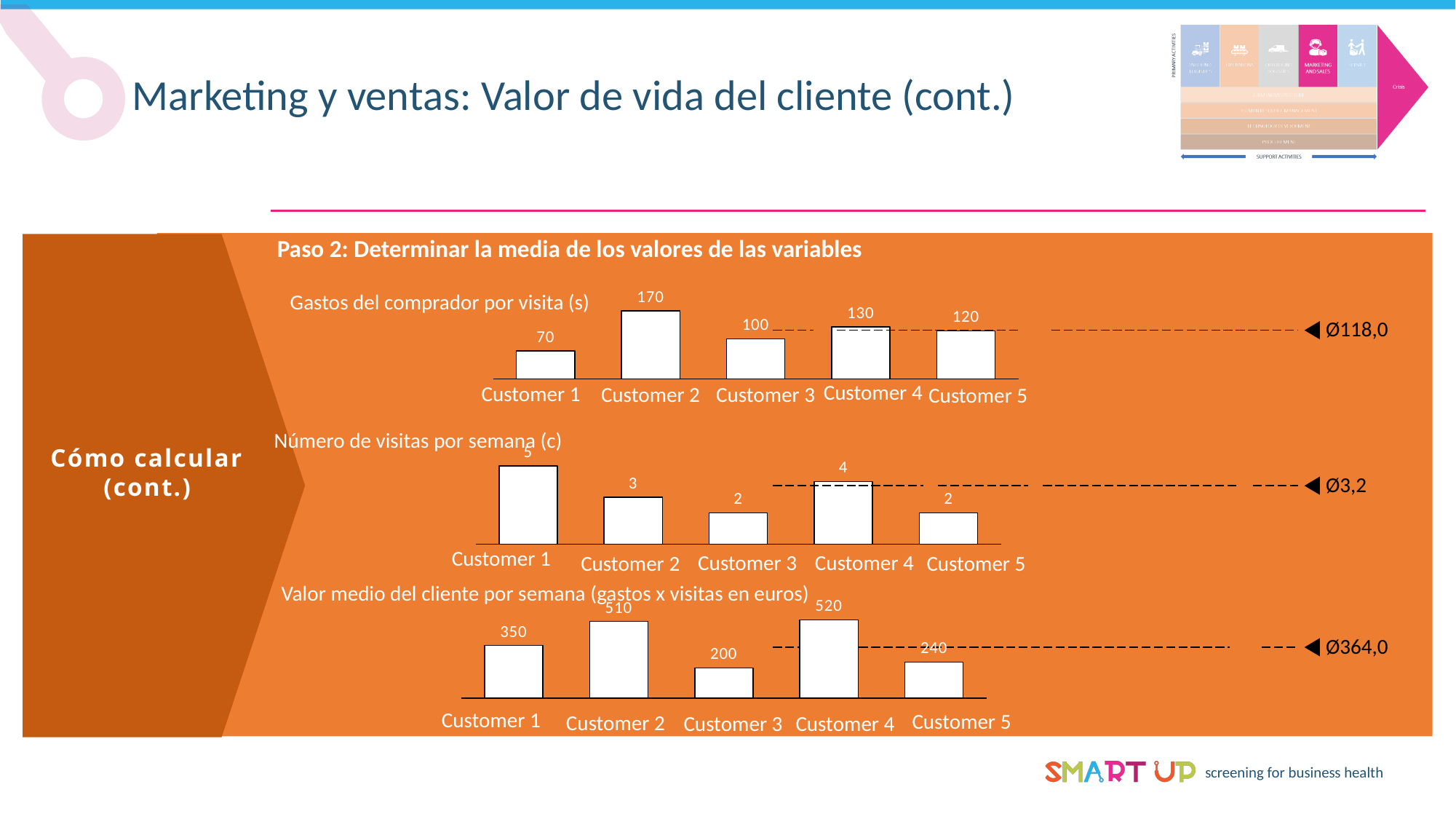
In the 'Gastos del comprador por visita (s)' chart, what is the value for Customer 2? 170 In the 'Número de visitas por semana (c)' chart, what is the value for Customer 4? 4 What kind of chart is the 'Gastos del comprador por visita (s)' chart? Bar chart In the 'Valor medio del cliente por semana' chart, which is larger, Customer 1 or Customer 5? Customer 1 What average value is shown to the right of the 'Valor medio del cliente por semana' chart? Ø364,0 What average value is shown to the right of the 'Número de visitas por semana (c)' chart? Ø3,2 In the 'Gastos del comprador por visita (s)' chart, which customer has the lowest value? Customer 1 In the 'Valor medio del cliente por semana' chart, what is the value for Customer 3? 200 In the 'Gastos del comprador por visita (s)' chart, what is the difference between Customer 2 and Customer 1? 100 In the 'Número de visitas por semana (c)' chart, which customer has the highest value? Customer 1 In the 'Valor medio del cliente por semana' chart, what is the difference between Customer 4 and Customer 3? 320 In the 'Número de visitas por semana (c)' chart, how many customers are shown? 5